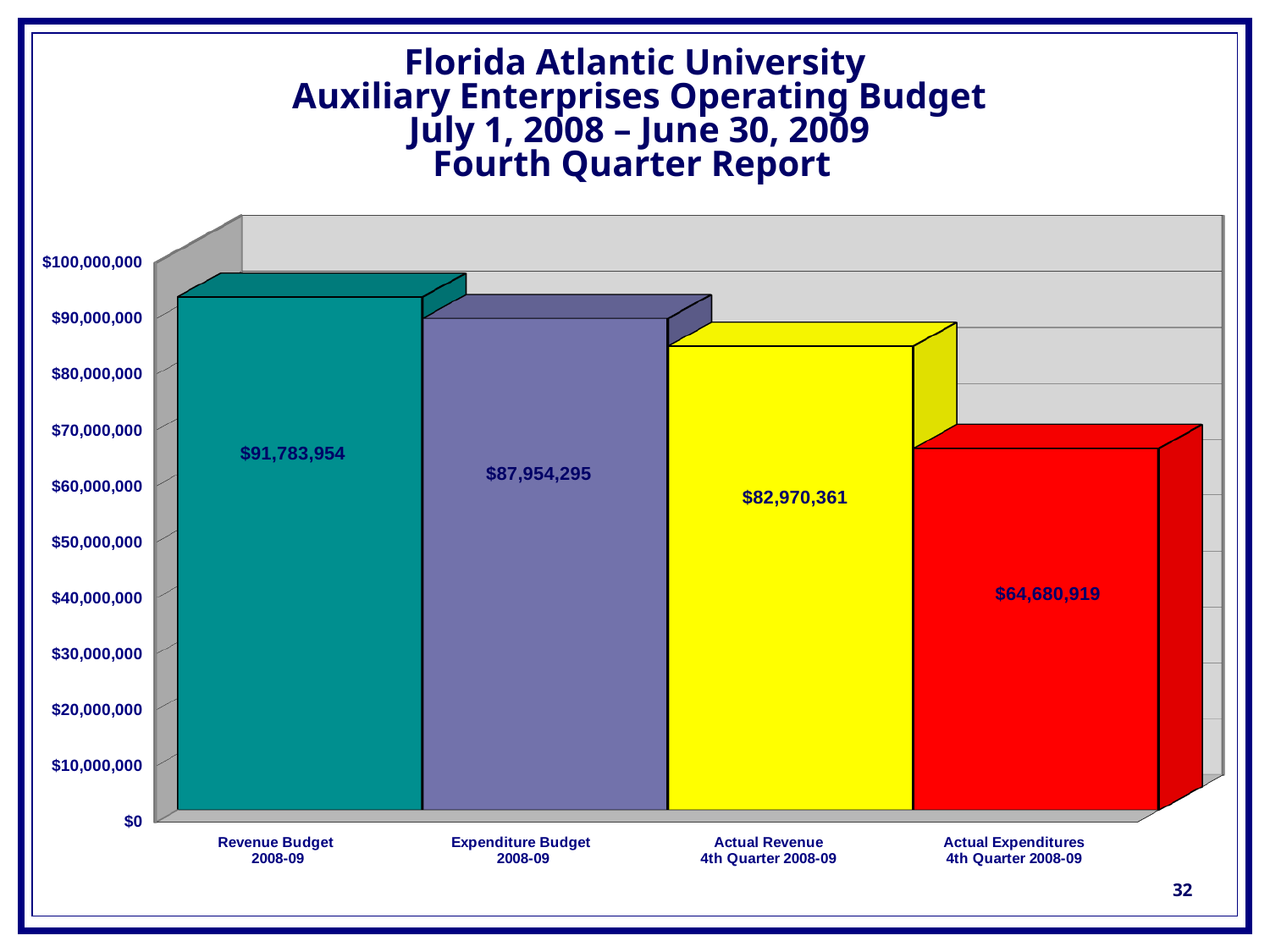
What is the value for Actual Expenditures 4th Quarter 2008-09? $64,680,919 Is the value for Actual Expenditures 4th Quarter 2008-09 greater or less than $70,000,000? less What is the difference between Actual Revenue 4th Quarter 2008-09 and Actual Expenditures 4th Quarter 2008-09? $18,289,442 Which category has the lowest value? Actual Expenditures 4th Quarter 2008-09 What is the difference between Revenue Budget 2008-09 and Expenditure Budget 2008-09? $3,829,659 Which is larger, Expenditure Budget 2008-09 or Actual Revenue 4th Quarter 2008-09? Expenditure Budget 2008-09 What kind of chart is shown on the slide? bar chart How many categories are shown in the chart? 4 Which category has the highest value? Revenue Budget 2008-09 What is the value for Revenue Budget 2008-09? $91,783,954 What is the value for Expenditure Budget 2008-09? $87,954,295 What is the value for Actual Revenue 4th Quarter 2008-09? $82,970,361